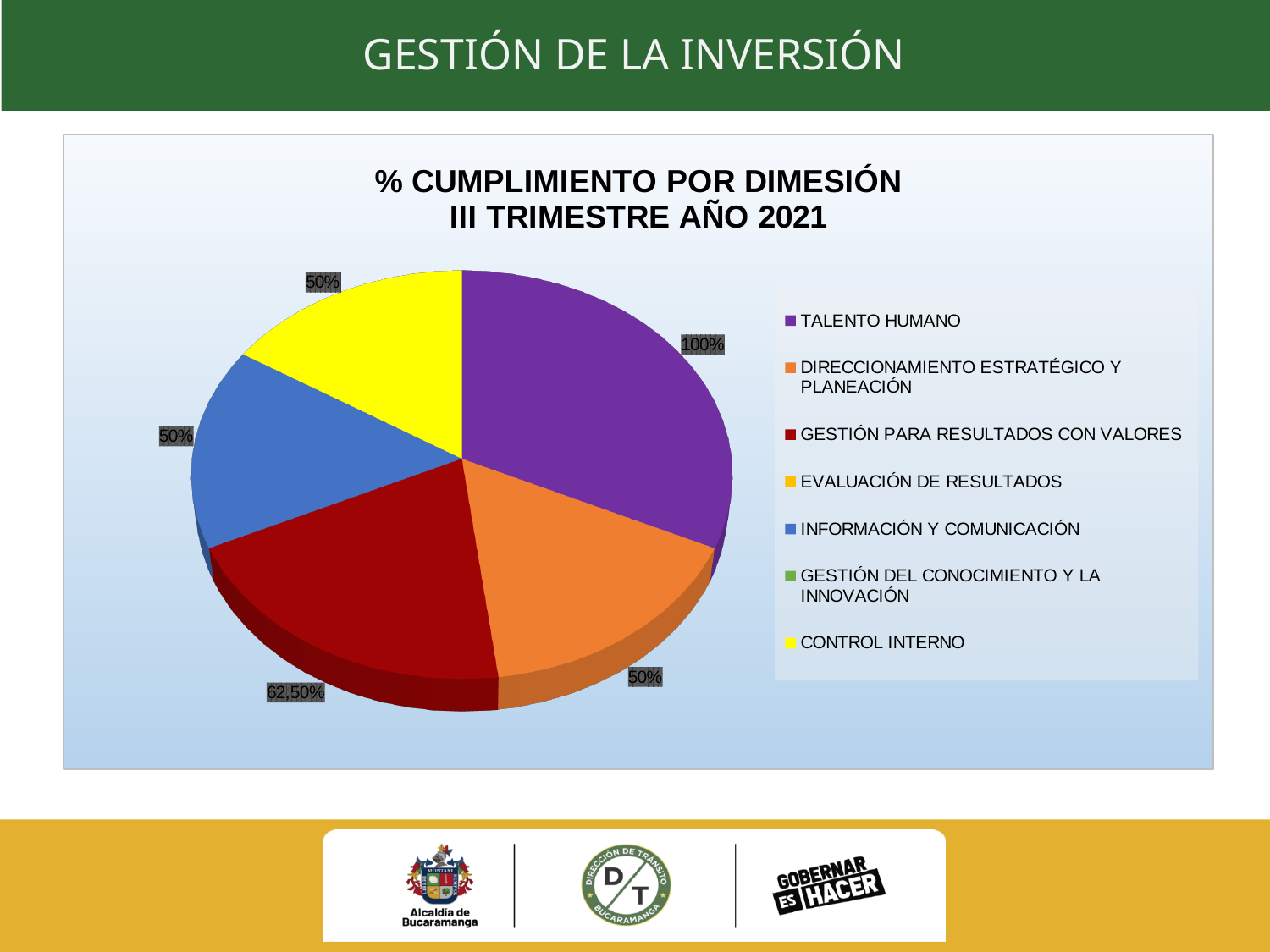
How many entries does the legend of the pie chart list? 7 What is the value shown for INFORMACIÓN Y COMUNICACIÓN? 50% What is the value shown for DIRECCIONAMIENTO ESTRATÉGICO Y PLANEACIÓN? 50% What is the title of the pie chart? % CUMPLIMIENTO POR DIMESIÓN III TRIMESTRE AÑO 2021 How many slices are visible in the pie chart? 5 What is the value shown for TALENTO HUMANO? 100% What is the value shown for GESTIÓN PARA RESULTADOS CON VALORES? 62,50% What is the difference between the value for GESTIÓN PARA RESULTADOS CON VALORES and the value for INFORMACIÓN Y COMUNICACIÓN? 12,50% What is the difference between the value for TALENTO HUMANO and the value for GESTIÓN PARA RESULTADOS CON VALORES? 37,50% What kind of chart is shown on the slide? Pie chart Which dimension has the highest value in the pie chart? TALENTO HUMANO Which is larger, the value for TALENTO HUMANO or the value for GESTIÓN PARA RESULTADOS CON VALORES? TALENTO HUMANO